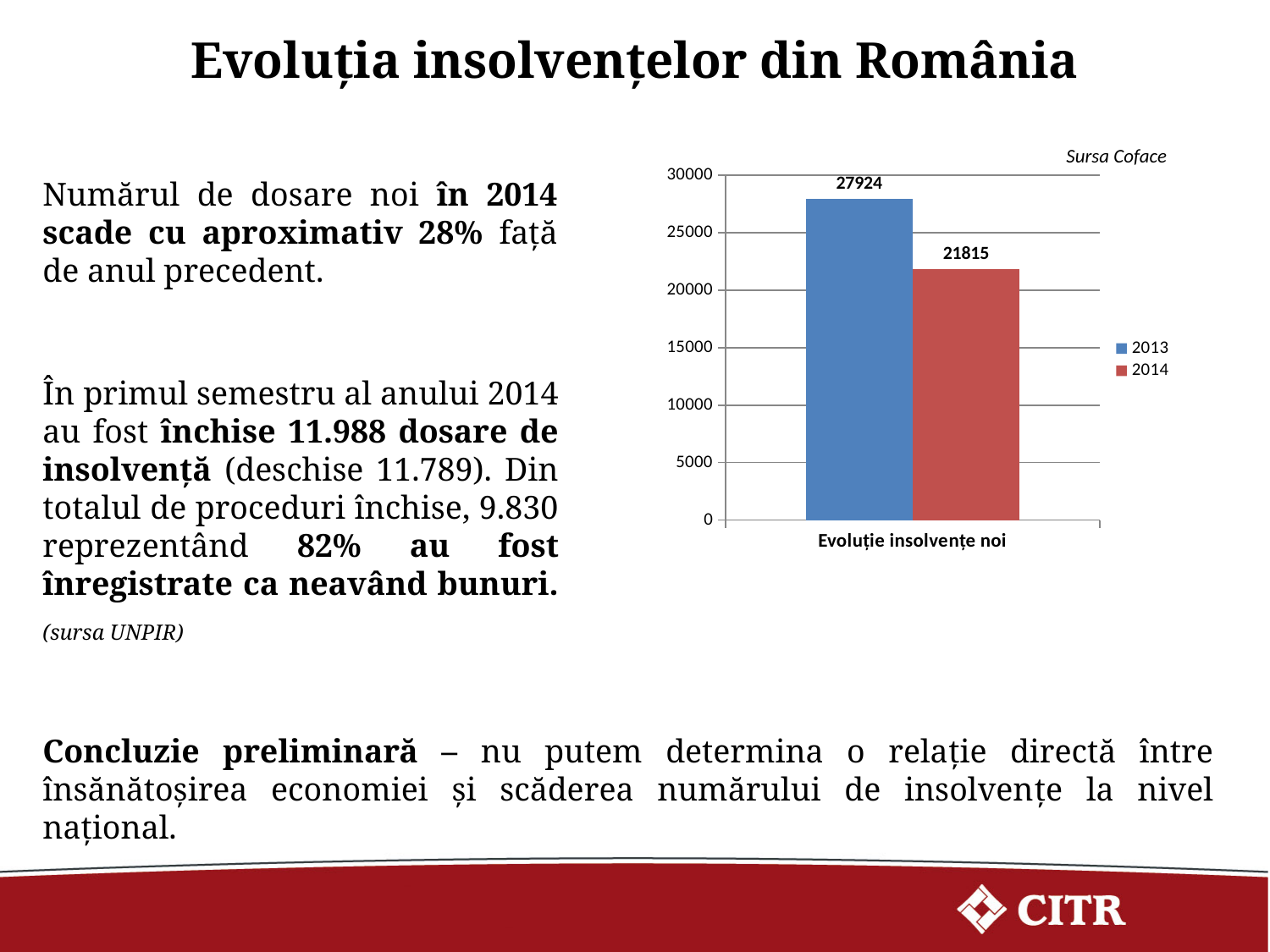
Is the value for 2013 greater or less than 25000? greater What colour is the bar for 2014? red What kind of chart is shown on the slide? bar chart What is the value for 2014 in the chart? 21815 Do the values fall or rise from 2013 to 2014? fall What is the difference between the 2013 and 2014 values? 6109 Is the value for 2014 greater or less than 25000? less Which series has the lowest value in the chart? 2014 How many series does the legend list? 2 Which series has the higher value, 2013 or 2014? 2013 What is the category label shown under the bars? Evoluție insolvențe noi What is the value for 2013 in the chart? 27924